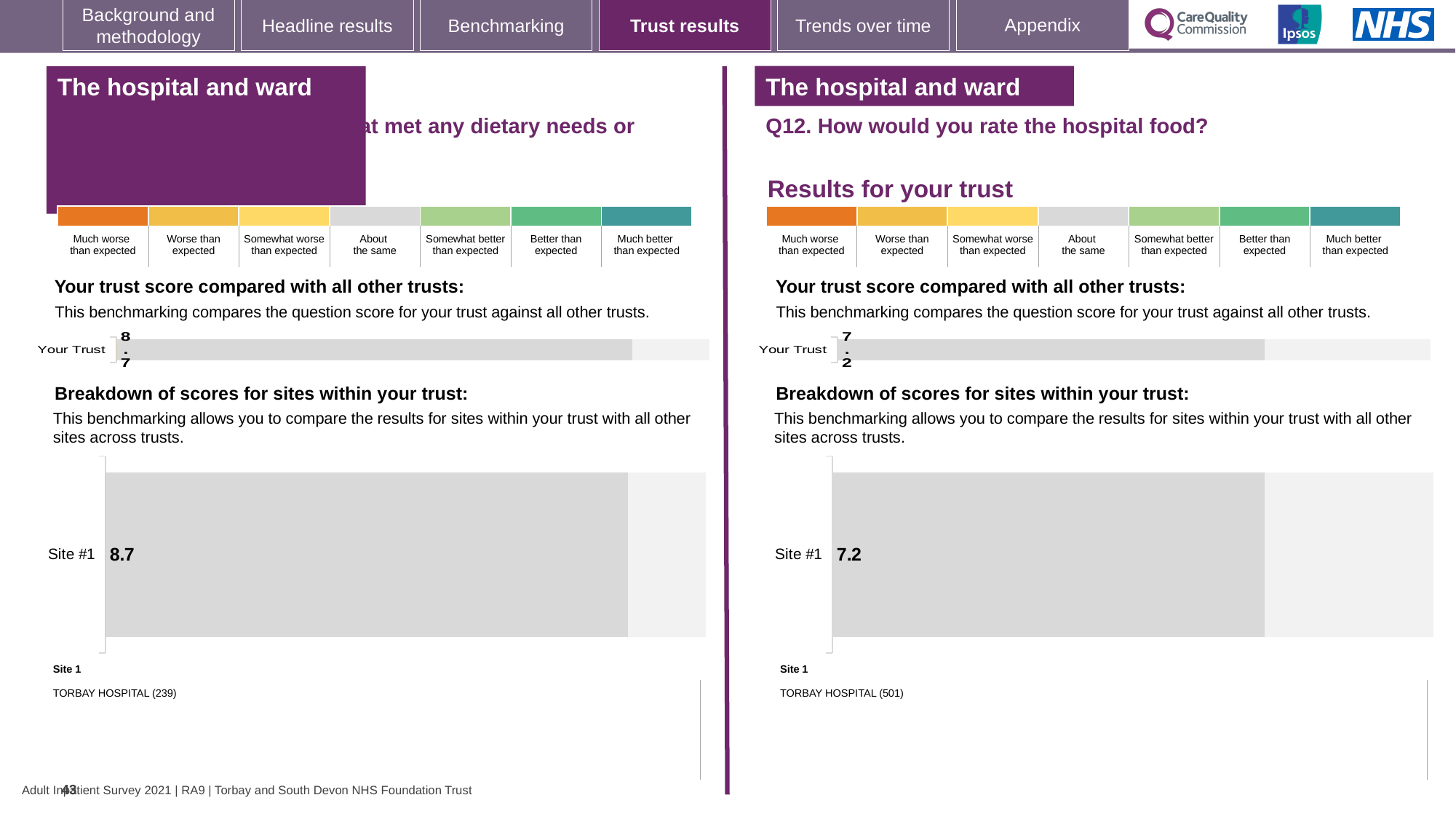
Which is larger: the Site #1 score on the left half of the slide or the Site #1 score on the right half (Q12)? Left half (8.7) What is the difference between the Your Trust score on the left half of the slide and the Your Trust score on the right half (Q12)? 1.5 On the left half of the slide, what is the score shown for Your Trust? 8.7 On the right half of the slide (Q12. How would you rate the hospital food?), what is the score shown for Site #1? 7.2 On the right half of the slide (Q12), is the Site #1 score greater or less than the Your Trust score, or are they equal? Equal On the left half of the slide, which hospital is listed as Site 1? TORBAY HOSPITAL (239) On the left half of the slide, what is the score shown for Site #1? 8.7 How many sites are shown in the breakdown of scores on the left half of the slide? 1 How many sites are shown in the breakdown of scores on the right half of the slide (Q12)? 1 On the right half of the slide (Q12. How would you rate the hospital food?), what is the score shown for Your Trust? 7.2 What kind of chart is used to show the Site #1 score on the right half of the slide (Q12)? Bar chart On the right half of the slide (Q12), which hospital is listed as Site 1? TORBAY HOSPITAL (501)